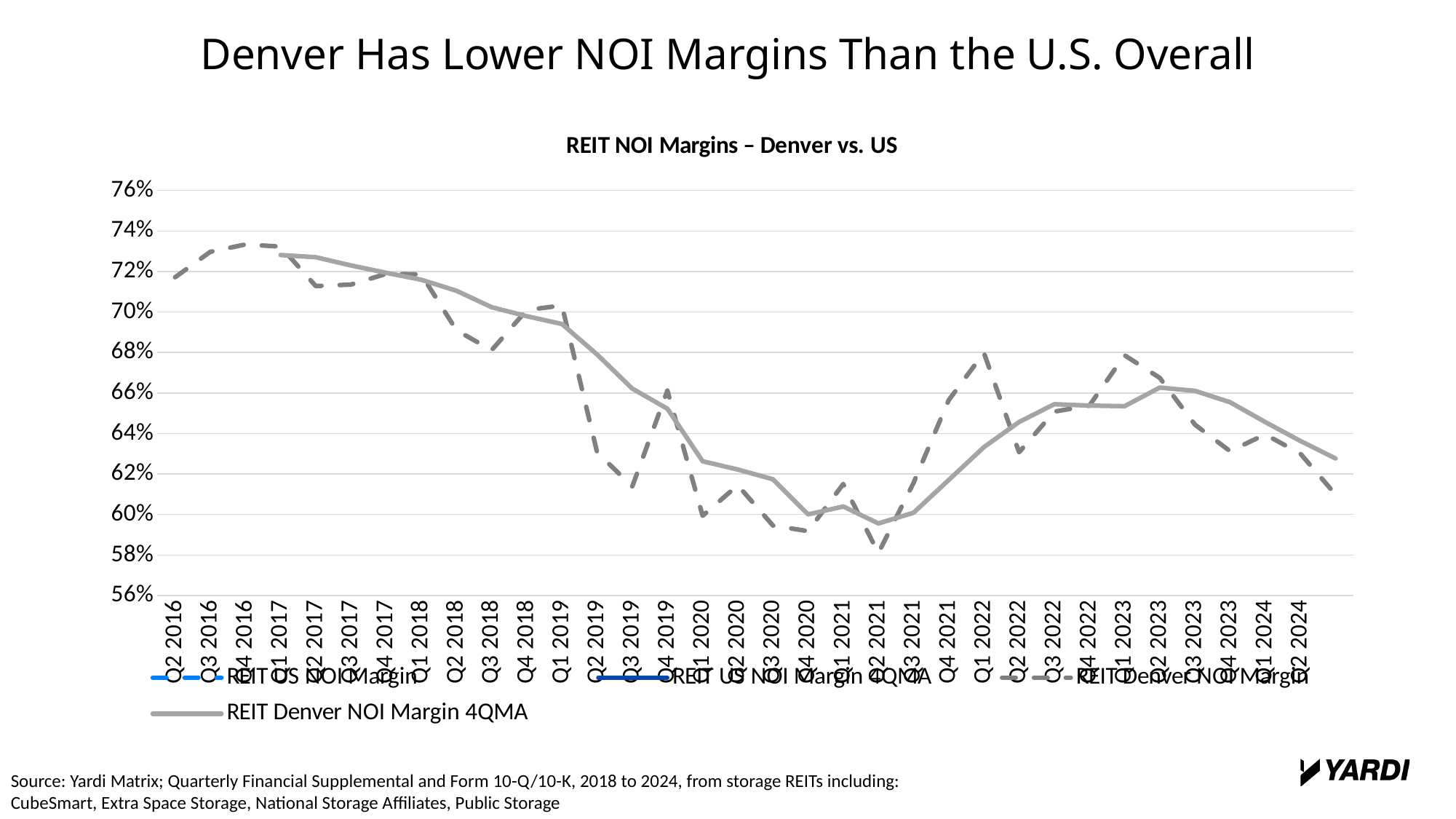
Is the REIT Denver NOI Margin 4QMA value for Q2 2024 greater or less than 64%? less Is the REIT Denver NOI Margin value for Q2 2021 greater or less than 60%? less Overall, does the REIT Denver NOI Margin 4QMA line rise or fall from Q1 2017 to Q2 2024? Fall How many quarters are shown along the x axis, from Q2 2016 to Q2 2024? 33 Is the REIT Denver NOI Margin 4QMA value for Q2 2023 greater or less than 64%? greater What is the title of the chart? REIT NOI Margins – Denver vs. US How many series does the chart's legend list? 4 What kind of chart is shown on the slide? Line chart Which is larger for the REIT Denver NOI Margin series: the value for Q1 2019 or the value for Q2 2019? Q1 2019 In which quarter does the REIT Denver NOI Margin 4QMA line reach its highest value? Q1 2017